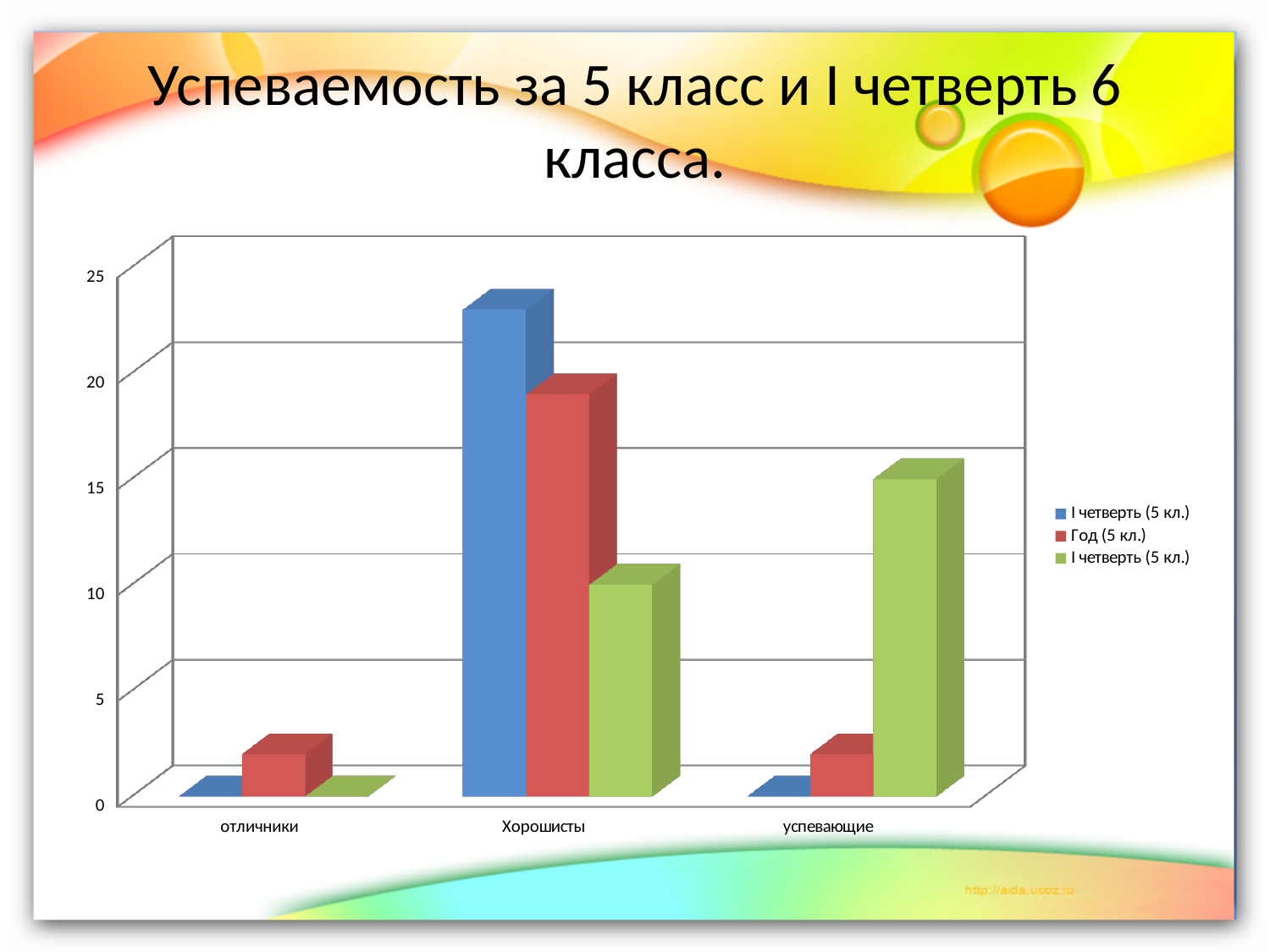
Is the red bar for Хорошисты greater or less than 15? greater For Хорошисты, which is larger: the blue bar or the green bar? the blue bar Which category has the tallest bar in the chart? Хорошисты How many series does the chart legend list? 3 Is the green bar for успевающие greater or less than 10? greater Is the red bar for отличники greater or less than 5? less For успевающие, which is larger: the green bar or the red bar? the green bar What is the title of the slide containing the chart? Успеваемость за 5 класс и I четверть 6 класса. How many categories are shown on the x axis of the chart? 3 What kind of chart is shown on the slide? bar chart Which category has the lowest green bar? отличники